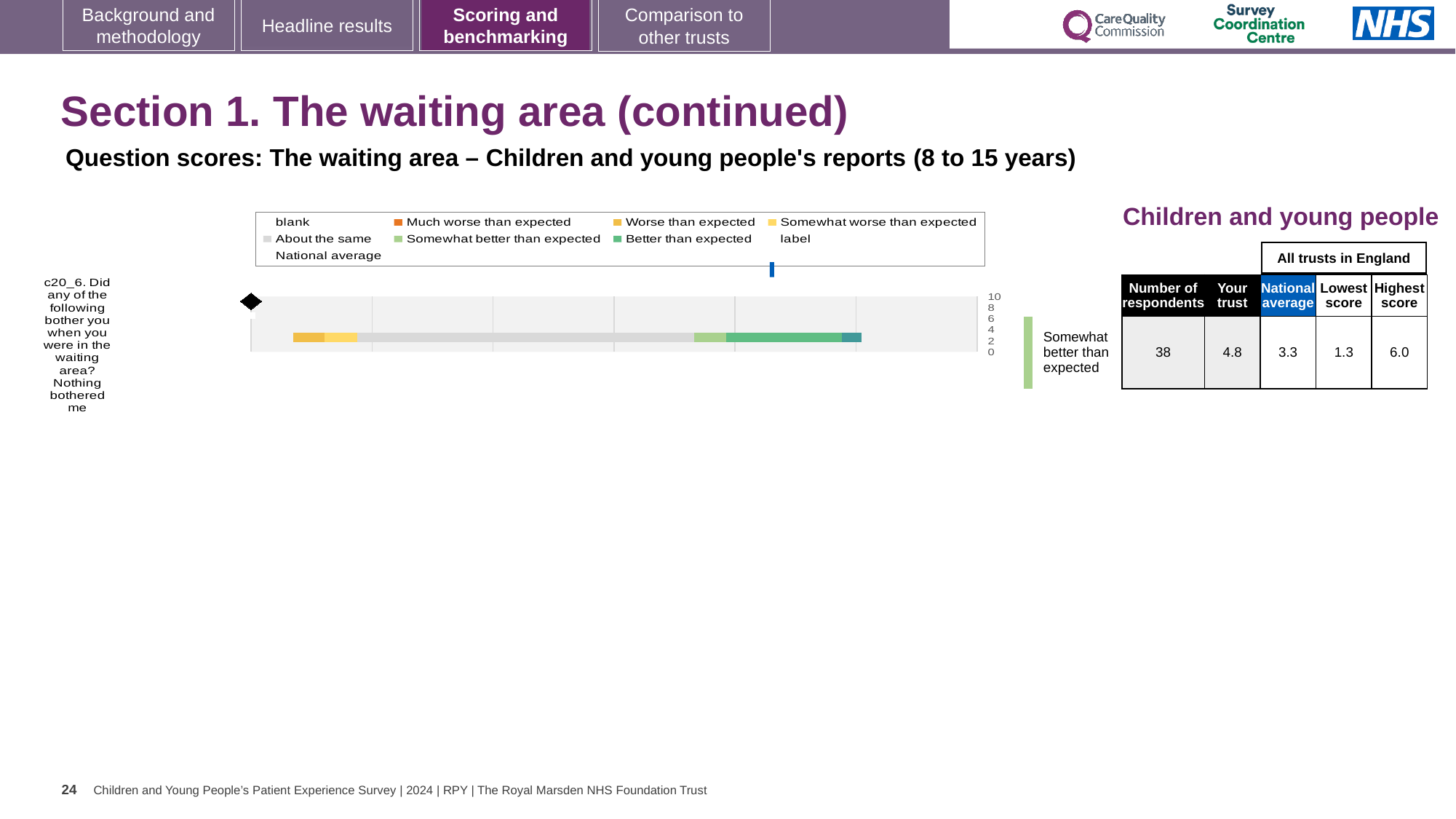
What colour does the legend use for 'Much worse than expected'? orange In the table next to the chart, what is the national average score for question c20_6? 3.3 What rating label is shown to the right of the bar for question c20_6? Somewhat better than expected How many entries does the chart legend list? 9 In the table next to the chart, what is the number of respondents for question c20_6? 38 How many question categories are plotted in the chart? 1 What is the highest value shown on the chart's score axis? 10 In the table next to the chart, what is the 'Your trust' score for question c20_6? 4.8 In the table next to the chart, what is the highest score among all trusts in England for question c20_6? 6.0 What kind of chart is shown on the slide? bar chart What is the difference between the highest score (6.0) and the lowest score (1.3) for question c20_6? 4.7 Which is larger for question c20_6: the 'Your trust' score or the national average? Your trust